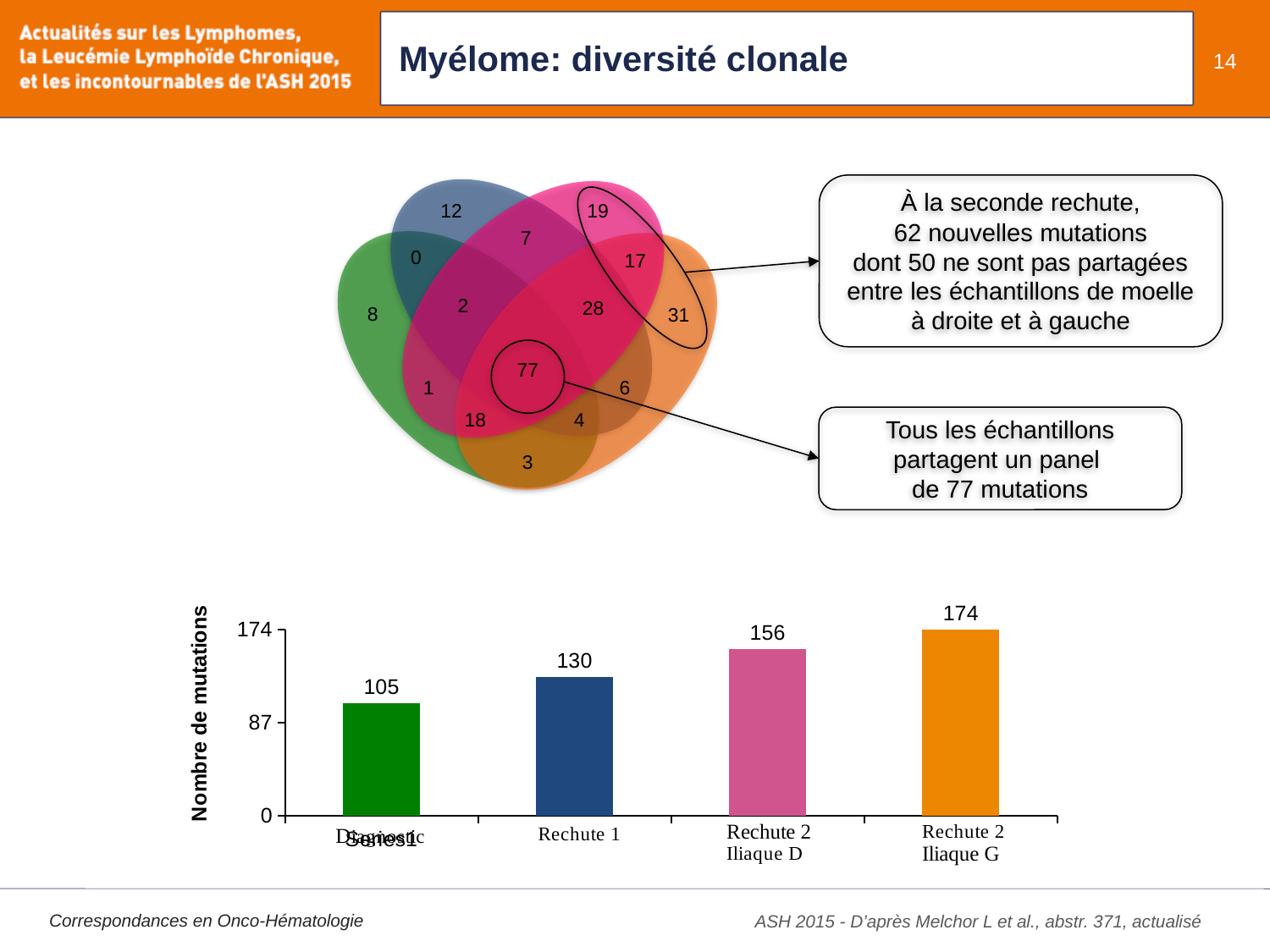
In the bar chart, which category has the highest number of mutations? Rechute 2 Iliaque G In the bar chart, which category has the lowest number of mutations? Diagnostic In the bar chart, what is the value for Rechute 2 Iliaque D? 156 In the bar chart, which is larger: Rechute 1 or Rechute 2 Iliaque D? Rechute 2 Iliaque D In the bar chart, what is the value for Rechute 1? 130 In the bar chart, what is the difference between Rechute 2 Iliaque G and Rechute 2 Iliaque D? 18 In the bar chart, what is the value of the leftmost bar (Diagnostic)? 105 How many bars are plotted in the bar chart? 4 In the bar chart, do the values rise or fall from left to right? rise In the bar chart, what is the value for Rechute 2 Iliaque G? 174 In the bar chart, what is the difference between Rechute 1 and Diagnostic? 25 What type of chart is shown at the bottom of the slide? bar chart